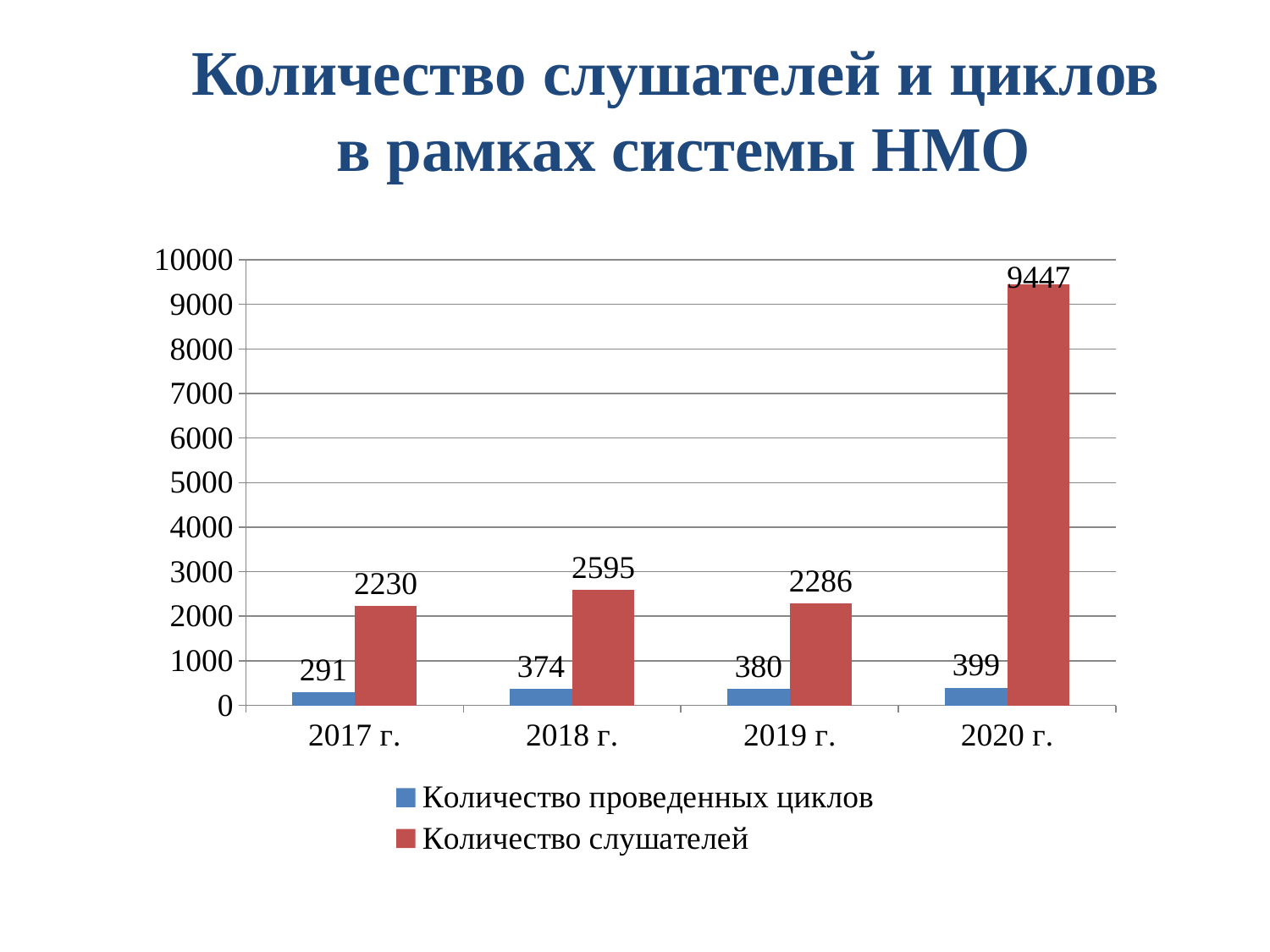
Which year has the lowest value for Количество проведенных циклов? 2017 г. Is the value for Количество слушателей in 2020 г. greater or less than 9000? greater How many series does the legend list? 2 What is the value of Количество слушателей for 2018 г.? 2595 What kind of chart is shown on the slide? Bar chart Which year has the highest value for Количество слушателей? 2020 г. How many years are shown on the x axis? 4 What is the value of Количество проведенных циклов for 2017 г.? 291 What is the value of Количество слушателей for 2020 г.? 9447 What is the difference between Количество слушателей in 2020 г. and 2019 г.? 7161 Which is larger: Количество слушателей in 2018 г. or in 2019 г.? 2018 г. Does Количество проведенных циклов rise or fall from 2017 г. to 2020 г.? Rise